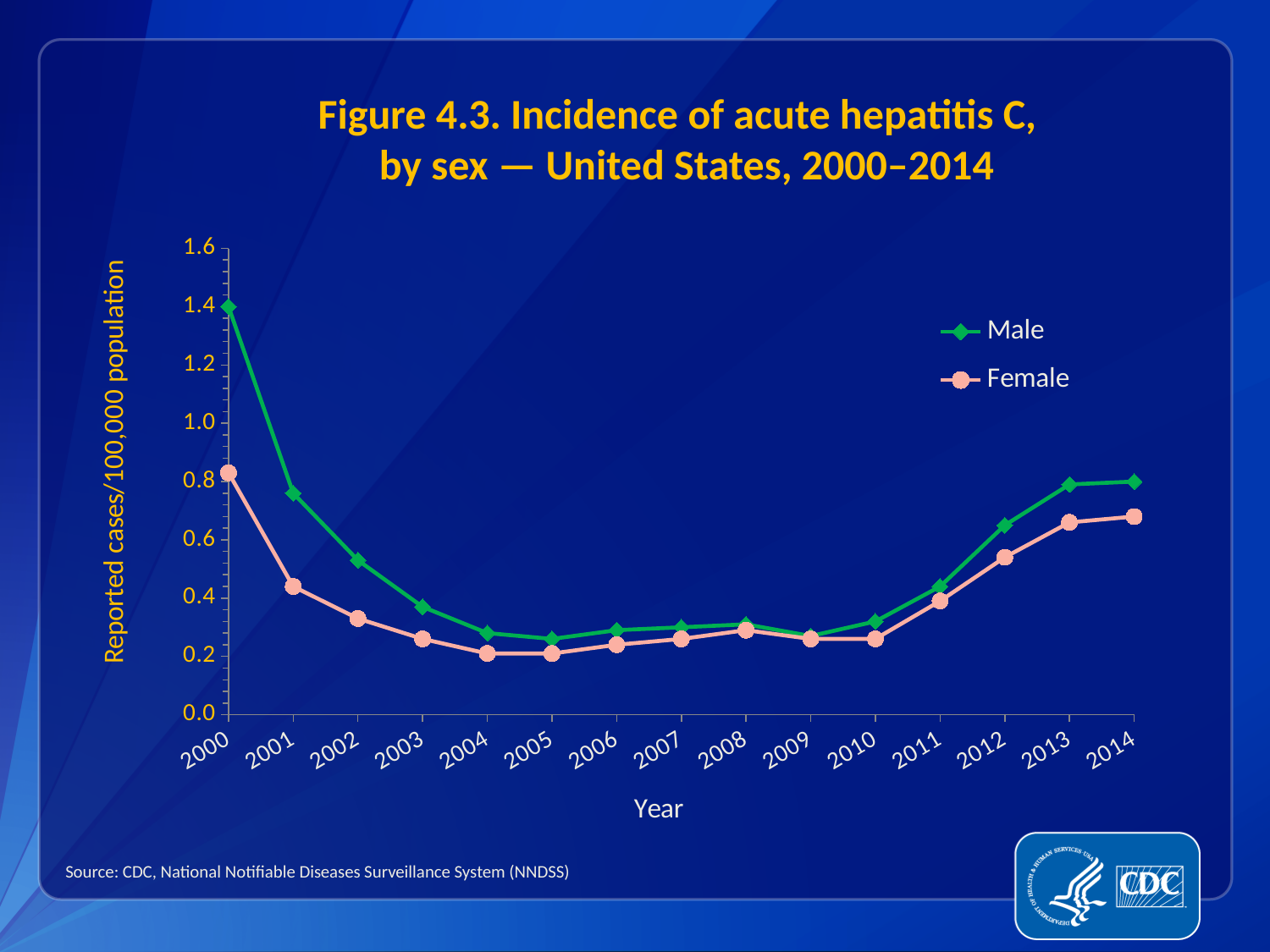
Is the Male value for 2000 greater or less than 1.2? greater Which year has the highest value for the Male series? 2000 In 2012, which series has the larger value, Male or Female? Male What is the label of the y axis? Reported cases/100,000 population How many years are plotted along the x axis? 15 Which year has the highest value for the Female series? 2000 Is the Male value for 2014 greater or less than 1.0? less What kind of chart is shown on the slide? line chart Do the Male values rise or fall from 2000 to 2005? fall Is the Female value for 2000 greater or less than 0.6? greater How many series does the legend list? 2